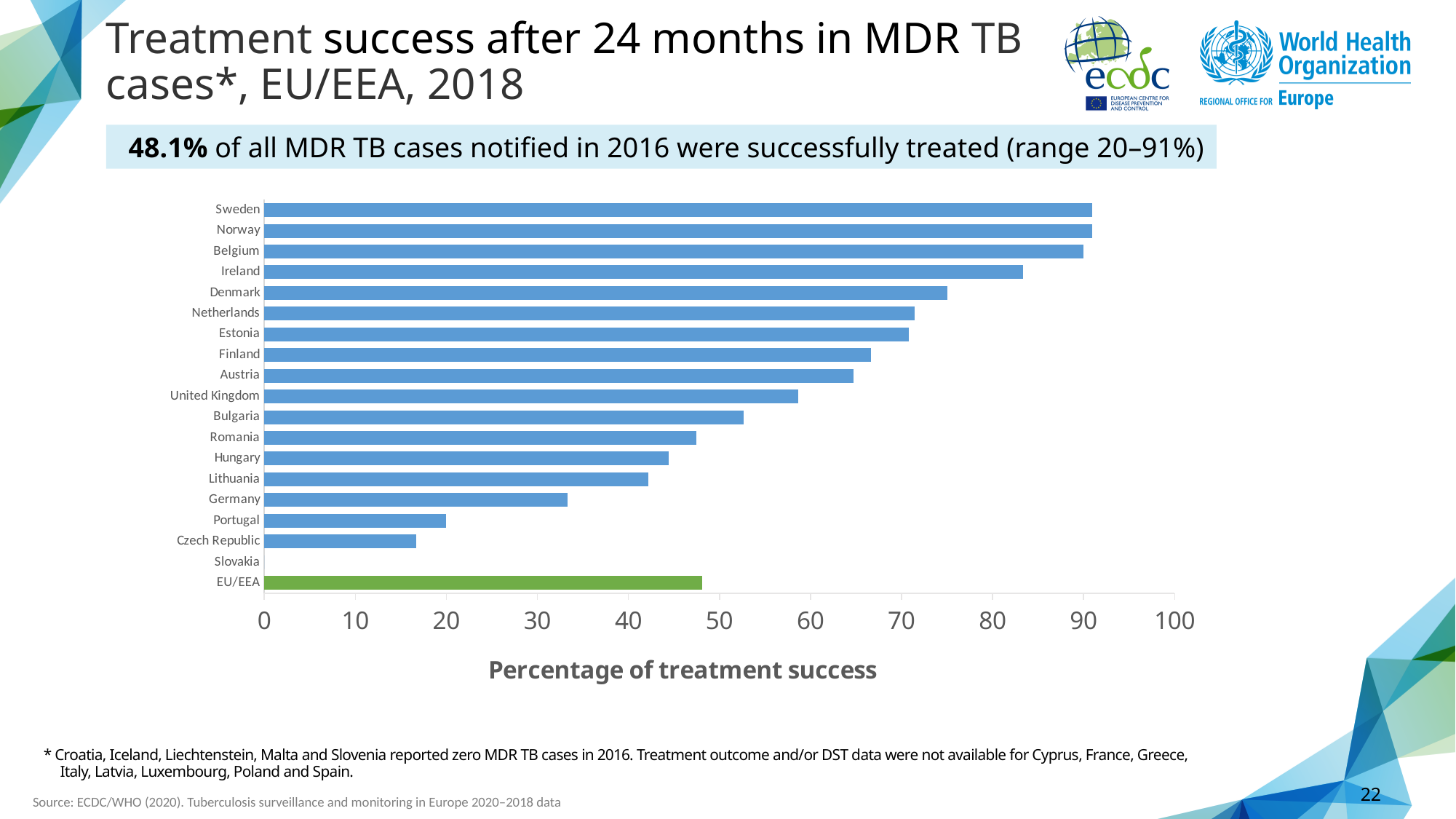
How many categories (bars) are listed on the chart? 19 What is the title of the x axis? Percentage of treatment success Is the value for Romania greater or less than 50? less Which category has the lowest percentage of treatment success? Slovakia What kind of chart is shown on the slide? bar chart Is the value for Czech Republic greater or less than 20? less Is the value for Ireland greater or less than 80? greater What is the percentage of treatment success for EU/EEA? 48.1% Which has a higher percentage of treatment success, Germany or Portugal? Germany Which has a higher percentage of treatment success, Belgium or Ireland? Belgium